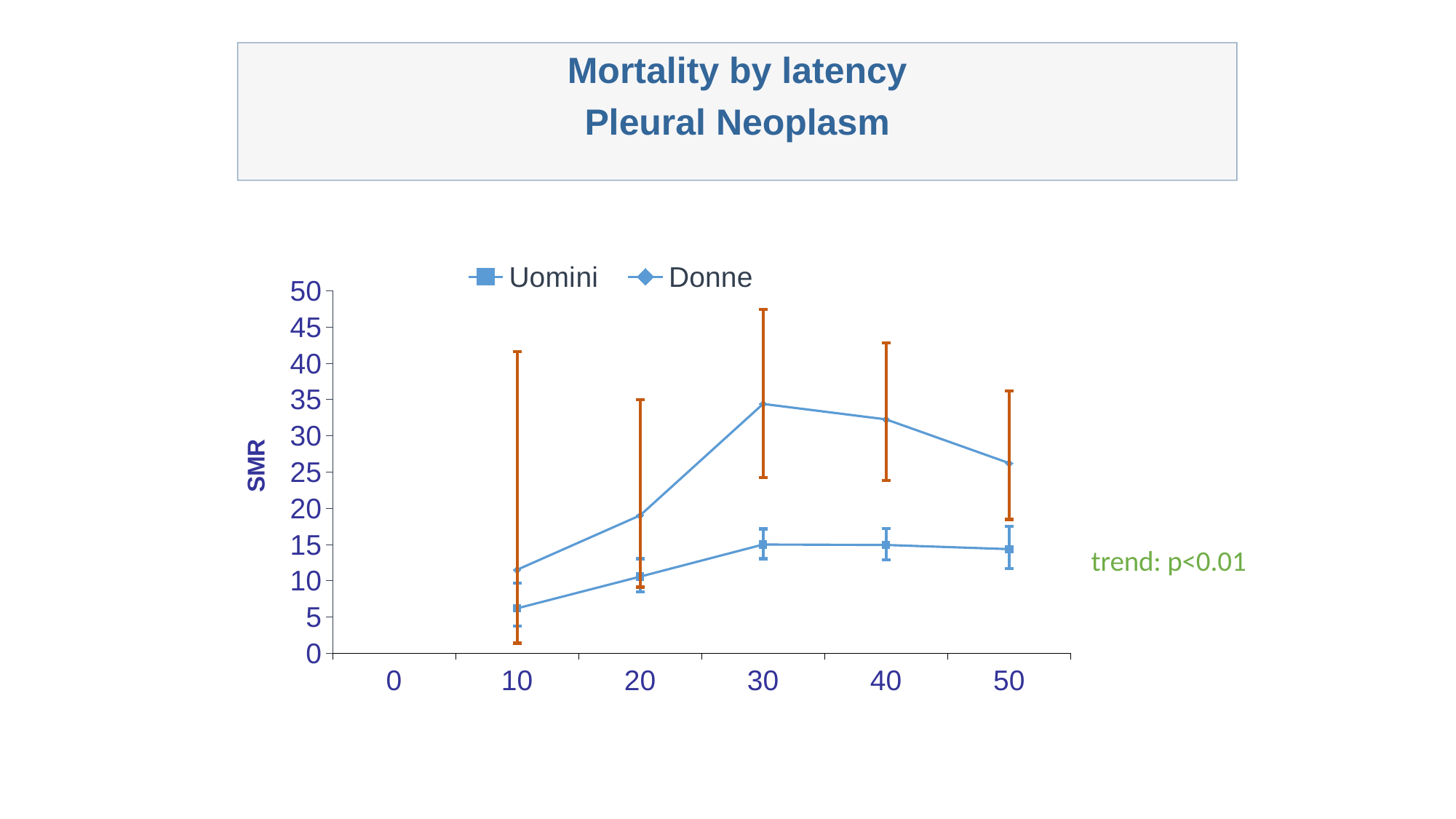
Is the Uomini value at latency 50 greater or less than 20? less Is the Uomini value at latency 10 greater or less than 10? less What is the label on the y axis? SMR What kind of chart is shown on the slide? line chart How many series does the legend list? 2 Is the Donne value at latency 30 greater or less than 30? greater Does the Donne series rise or fall between latency 30 and latency 50? fall At latency 30, which series has the higher SMR, Uomini or Donne? Donne At which latency value is the Donne series lowest? 10 At which latency value does the Donne series reach its highest SMR? 30 At which latency value is the Uomini series lowest? 10 What are the two series named in the legend? Uomini and Donne